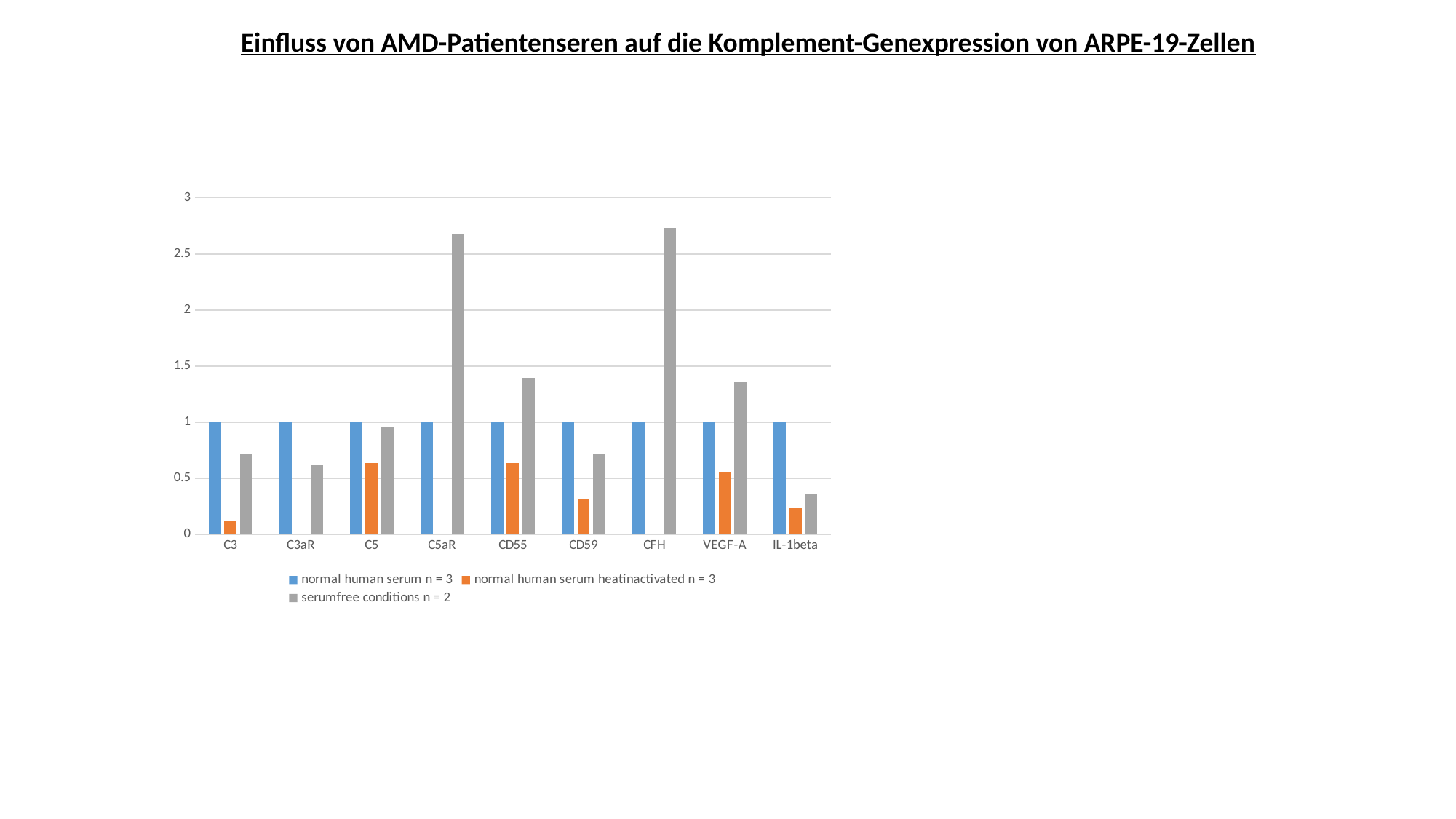
What is the value for CFH in the 'normal human serum n = 3' series? 1 Which category has the lowest value in the 'serumfree conditions n = 2' series? IL-1beta How many series does the legend list? 3 Is the value for CD55 in the 'serumfree conditions n = 2' series greater or less than 1? greater Is the value for C3 in the 'serumfree conditions n = 2' series greater or less than 1? less Is the value for C5aR in the 'serumfree conditions n = 2' series greater or less than 2.5? greater How many gene categories are shown on the x axis? 9 What kind of chart is shown on the slide? bar chart In the 'serumfree conditions n = 2' series, which is larger: C5aR or C3? C5aR What is the title of the chart? Einfluss von AMD-Patientenseren auf die Komplement-Genexpression von ARPE-19-Zellen What is the value for C3 in the 'normal human serum n = 3' series? 1